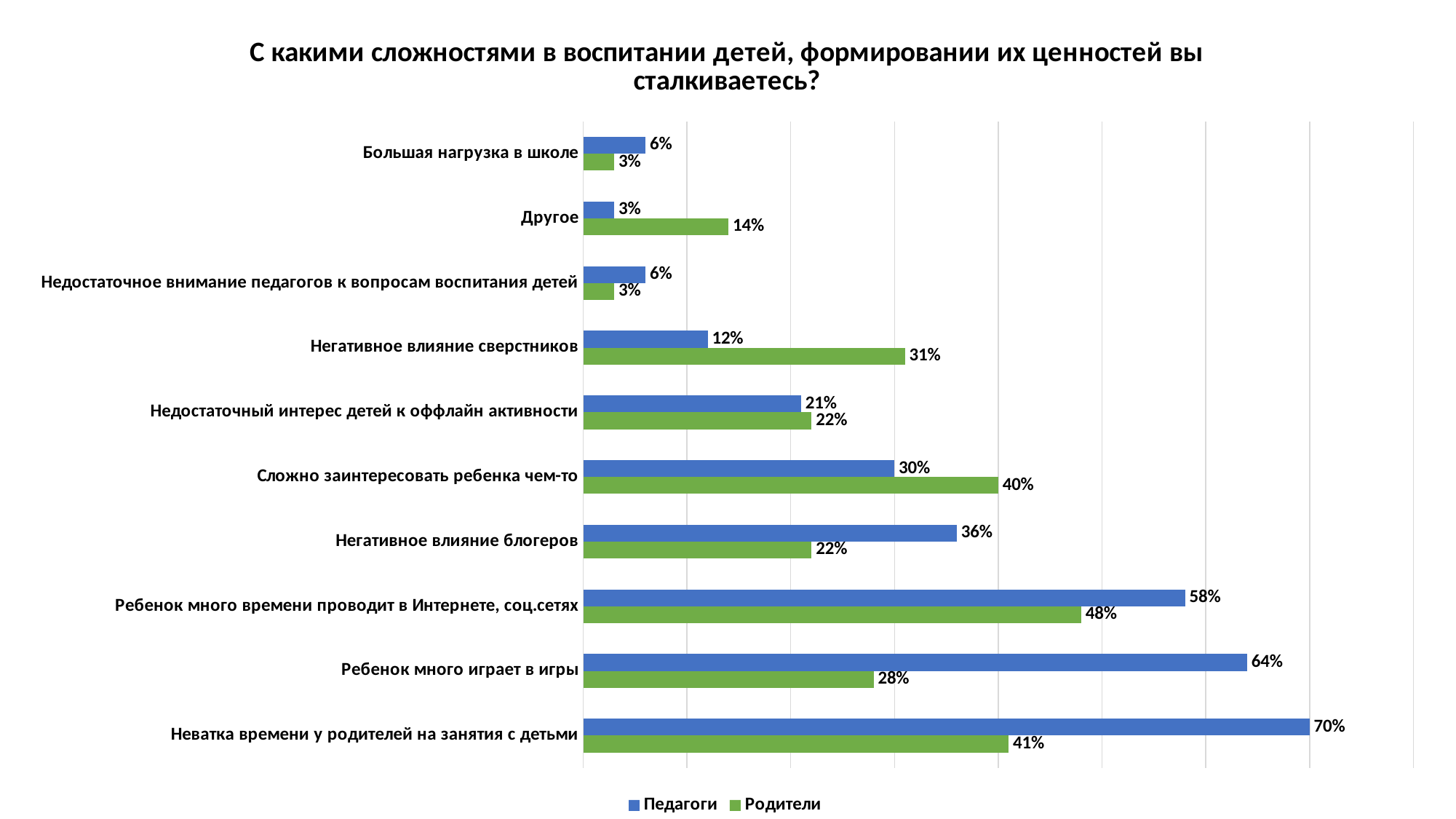
How many series does the legend list? 2 What is the difference between the Педагоги and Родители values for "Ребенок много играет в игры"? 36% Which colour represents the Родители series in the chart? Green Which category has the lowest value for Педагоги? Другое What is the value for Педагоги in the category "Неватка времени у родителей на занятия с детьми"? 70% For "Сложно заинтересовать ребенка чем-то", which series has the larger value, Педагоги or Родители? Родители Which category has the highest value for Родители? Ребенок много времени проводит в Интернете, соц.сетях Which category has the highest value for Педагоги? Неватка времени у родителей на занятия с детьми How many categories are shown in the chart? 10 What is the value for Родители in the category "Другое"? 14% What is the value for Родители in the category "Негативное влияние сверстников"? 31% What type of chart is shown on the slide? Bar chart